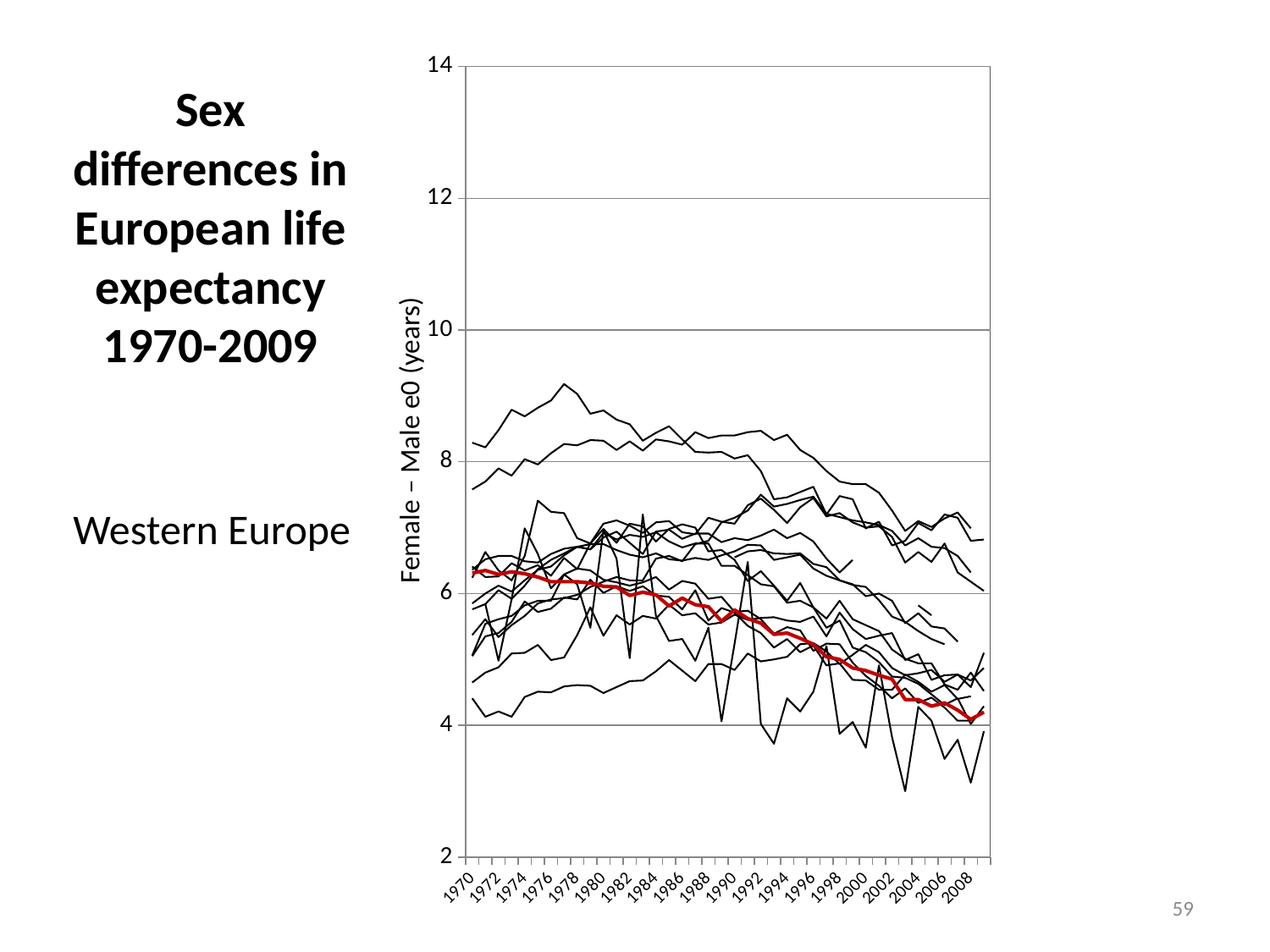
Is the value of the thick red line in 2000 greater or less than 6? less What is the label on the vertical axis of the chart? Female – Male e0 (years) Is the value of the thick red line in 2000 greater or less than 4? greater Which is larger for the thick red line: its value in 1970 or its value in 2008? 1970 What is the title of the slide's chart? Sex differences in European life expectancy 1970-2009 Is the value of the thick red line in 1990 greater or less than 6? less What kind of chart is shown on the slide? line chart What is the highest value shown on the vertical axis? 14 Does the thick red line generally rise or fall from 1970 to 2009? fall